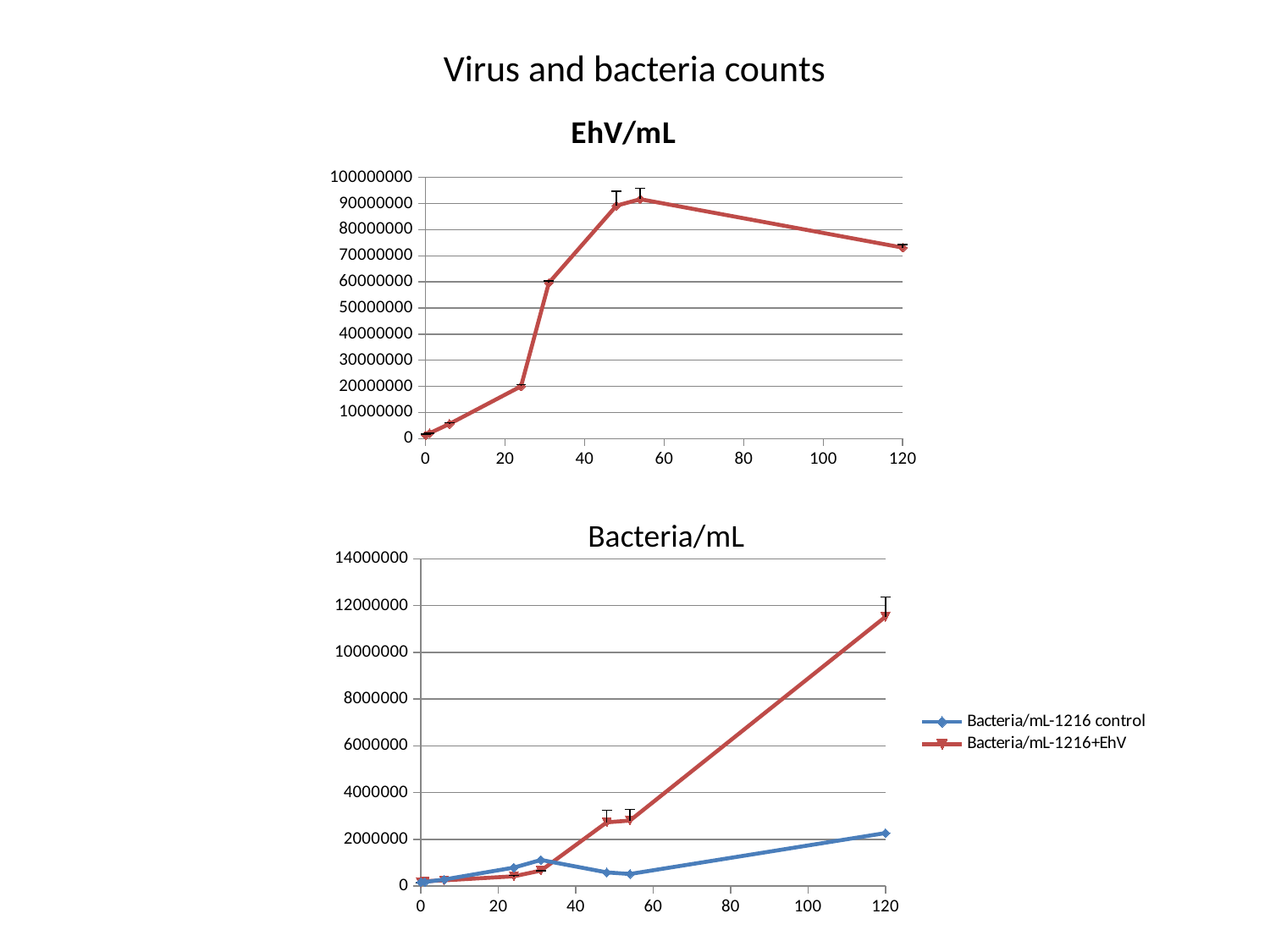
In the Bacteria/mL chart, is the Bacteria/mL-1216 control value at x = 120 greater or less than 4000000? less In the Bacteria/mL chart, what colour is the Bacteria/mL-1216 control line? blue In the Bacteria/mL chart, which series has the larger value at x = 120? Bacteria/mL-1216+EhV How many series does the legend of the Bacteria/mL chart list? 2 What kind of chart is the Bacteria/mL chart? line chart What kind of chart is the EhV/mL chart? line chart In the EhV/mL chart, is the value at x = 6 greater or less than 10000000? less In the EhV/mL chart, does the line rise or fall between x = 54 and x = 120? fall In the Bacteria/mL chart, is the Bacteria/mL-1216+EhV value at x = 120 greater or less than 10000000? greater In the Bacteria/mL chart, does the Bacteria/mL-1216+EhV line rise or fall between x = 54 and x = 120? rise